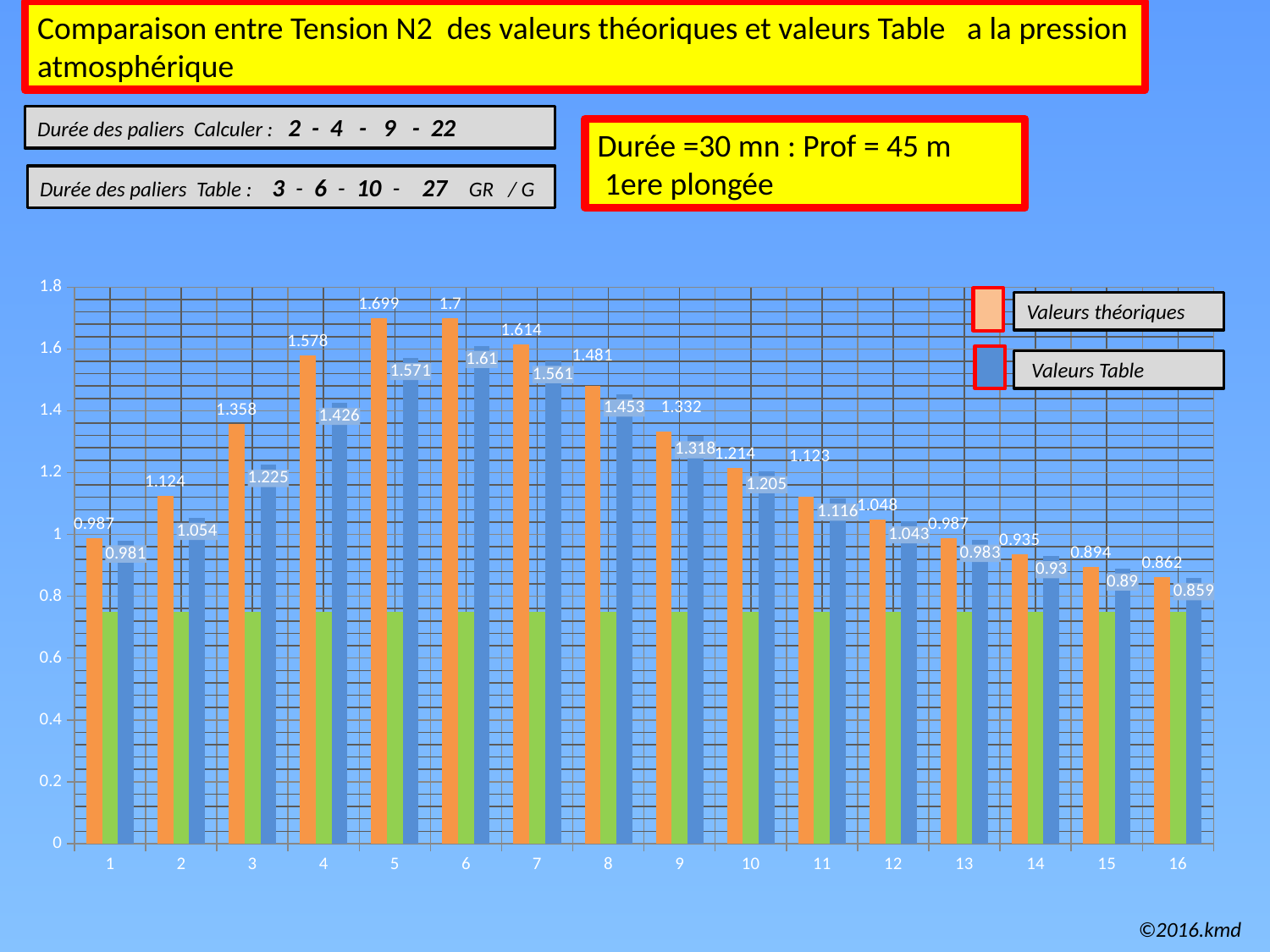
How many categories are shown on the x axis? 16 Do the Valeurs théoriques values rise or fall from category 6 to category 16? Fall How many series does the legend list? 2 What is the difference between the Valeurs théoriques and Valeurs Table values for category 3? 0.133 What is the Valeurs théoriques value for category 6? 1.7 Which is larger for category 2: the Valeurs théoriques value or the Valeurs Table value? Valeurs théoriques Which category has the lowest Valeurs théoriques value? 16 What kind of chart is shown on the slide? Bar chart What is the Valeurs Table value for category 4? 1.426 Which category has the highest Valeurs Table value? 6 What is the Valeurs théoriques value for category 13? 0.987 Is the Valeurs Table value for category 5 greater or less than 1.4? greater